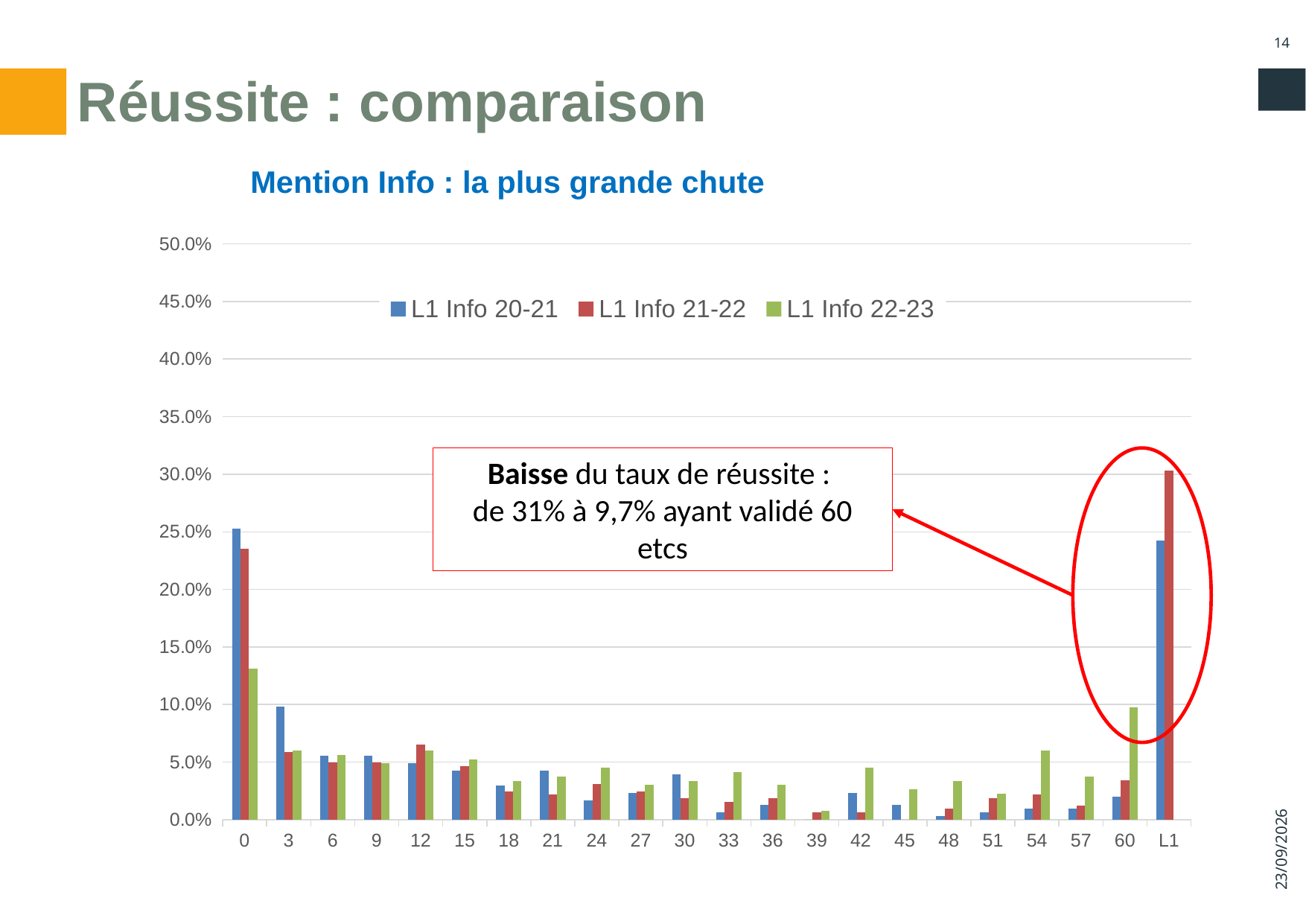
What is the title shown above the chart? Mention Info : la plus grande chute Is the value for L1 Info 22-23 at category 60 greater or less than 5.0%? greater Is the value for L1 Info 22-23 at category 0 greater or less than 15.0%? less At category L1, which series has the larger value: L1 Info 20-21 or L1 Info 21-22? L1 Info 21-22 For the series L1 Info 21-22, which category has the highest value? L1 What are the three series named in the chart legend? L1 Info 20-21, L1 Info 21-22, L1 Info 22-23 At category 0, which series has the larger value: L1 Info 20-21 or L1 Info 22-23? L1 Info 20-21 How many series does the chart legend list? 3 Is the value for L1 Info 21-22 at category L1 greater or less than 25.0%? greater How many categories are shown along the x axis of the chart? 22 What kind of chart is shown on the slide? Bar chart